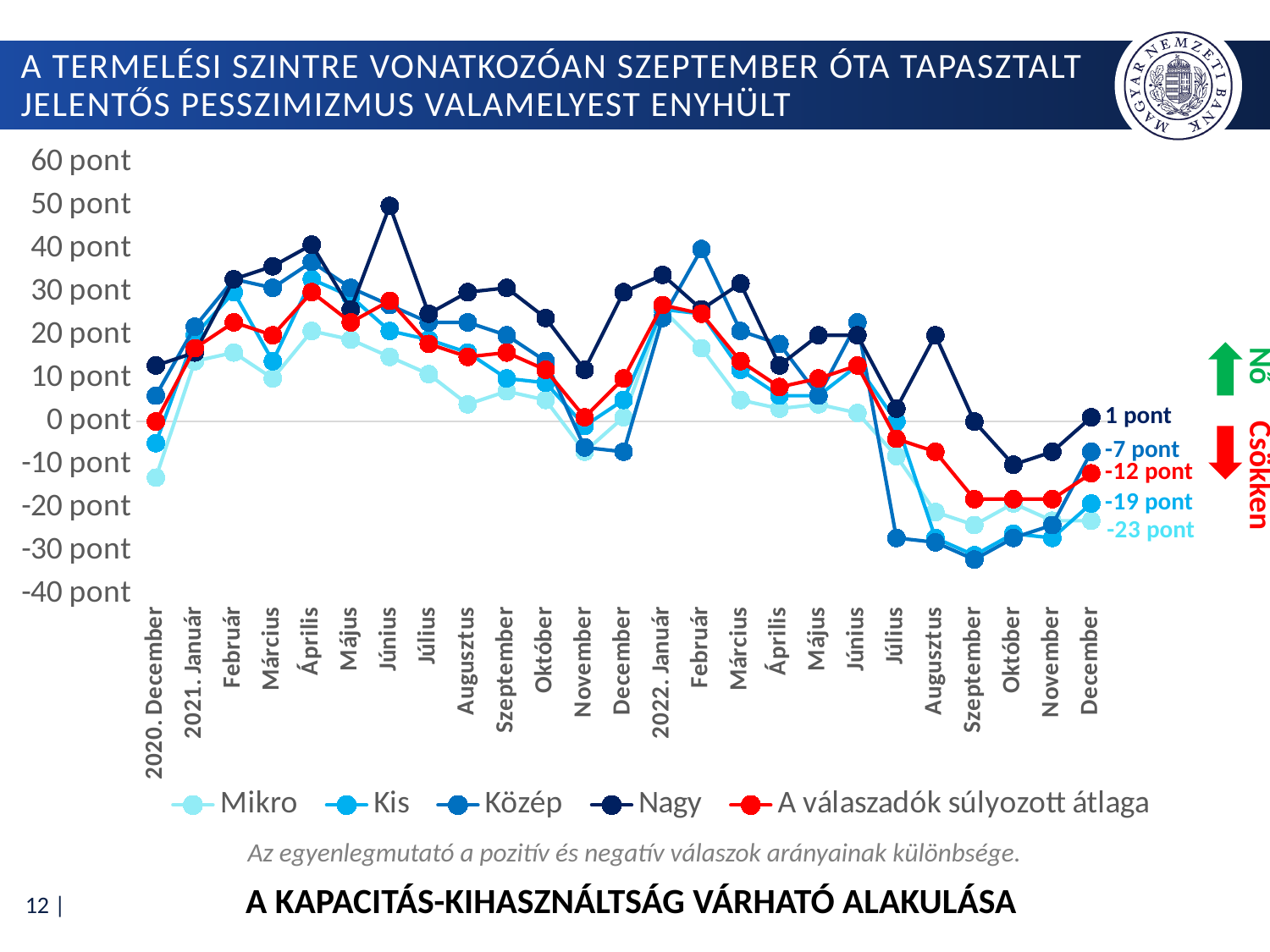
In 2022 December, which is larger: the Közép value or the Kis value? Közép Which series has the lowest value in 2022 December? Mikro Is the value of the Nagy series in 2021 Június greater or less than 40 pont? greater Does the 'A válaszadók súlyozott átlaga' series rise or fall from 2022 Június to 2022 Szeptember? fall What is the value of the Mikro series in 2022 December? -23 pont Which series has the highest value in 2022 December? Nagy What kind of chart is shown on the slide? line chart How many series does the legend list? 5 What is the difference between the Nagy and Mikro values in 2022 December? 24 pont What is the value of 'A válaszadók súlyozott átlaga' in 2022 December? -12 pont What is the value of the Nagy series in 2022 December? 1 pont What is the value of the Kis series in 2022 December? -19 pont